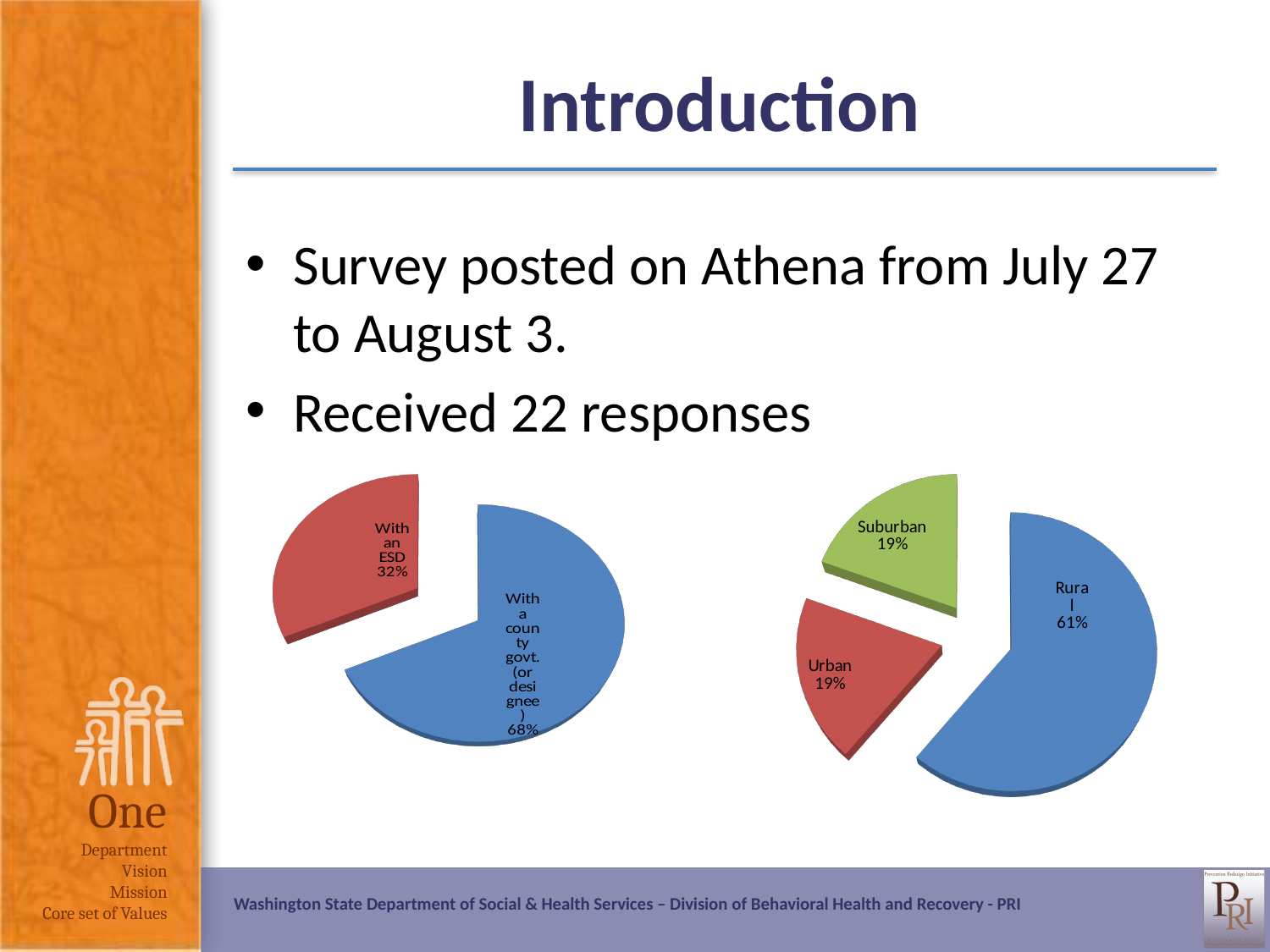
In the right pie chart, what share is labelled "Suburban"? 19% How many slices does the left pie chart have? 2 In the left pie chart, what share is labelled "With a county govt. (or designee)"? 68% What type of chart is shown on the right side of the slide? Pie chart In the right pie chart, what is the difference in percentage points between the "Rural" slice and the "Urban" slice? 42 In the left pie chart, which slice is the largest? With a county govt. (or designee) How many slices does the right pie chart have? 3 In the right pie chart, which slice is the largest? Rural In the right pie chart, what share is labelled "Urban"? 19% In the left pie chart, what is the difference in percentage points between the "With a county govt. (or designee)" slice and the "With an ESD" slice? 36 In the left pie chart, what share is labelled "With an ESD"? 32% In the right pie chart, what share is labelled "Rural"? 61%